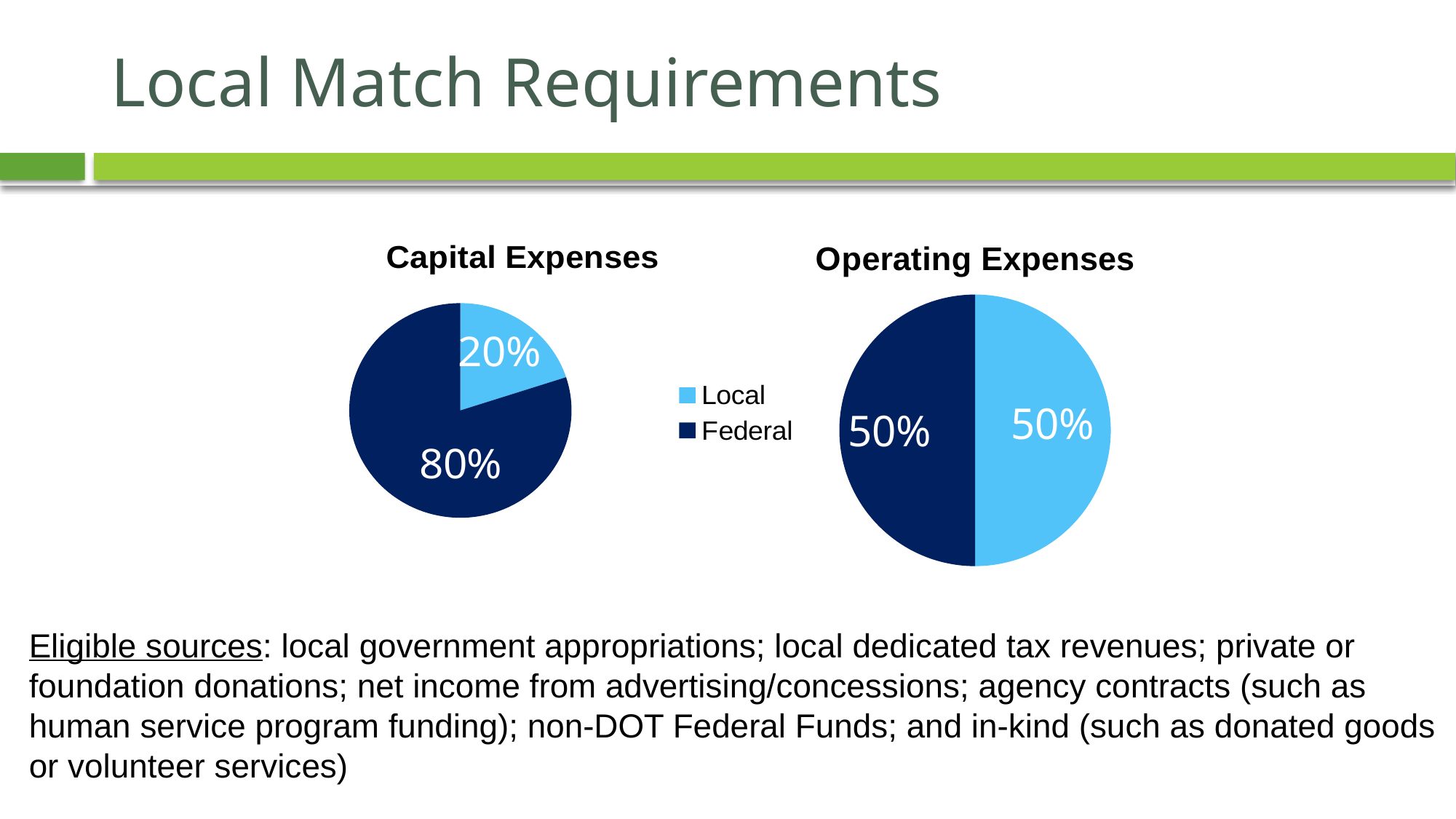
In the Capital Expenses chart, which category has the largest slice? Federal What kind of chart is the Capital Expenses chart? Pie chart How many slices does the Operating Expenses chart have? 2 In the Operating Expenses chart, what share is Federal? 50% In the Capital Expenses chart, what is the difference between the Federal and Local shares? 60% In the Operating Expenses chart, what share is Local? 50% In the Capital Expenses chart, which is larger, Local or Federal? Federal In the Capital Expenses chart, which category has the smallest slice? Local In the Capital Expenses chart, what share is Local? 20% In the Capital Expenses chart, what share is Federal? 80% Which colour represents Federal in the legend? Dark blue How many entries does the legend list? 2